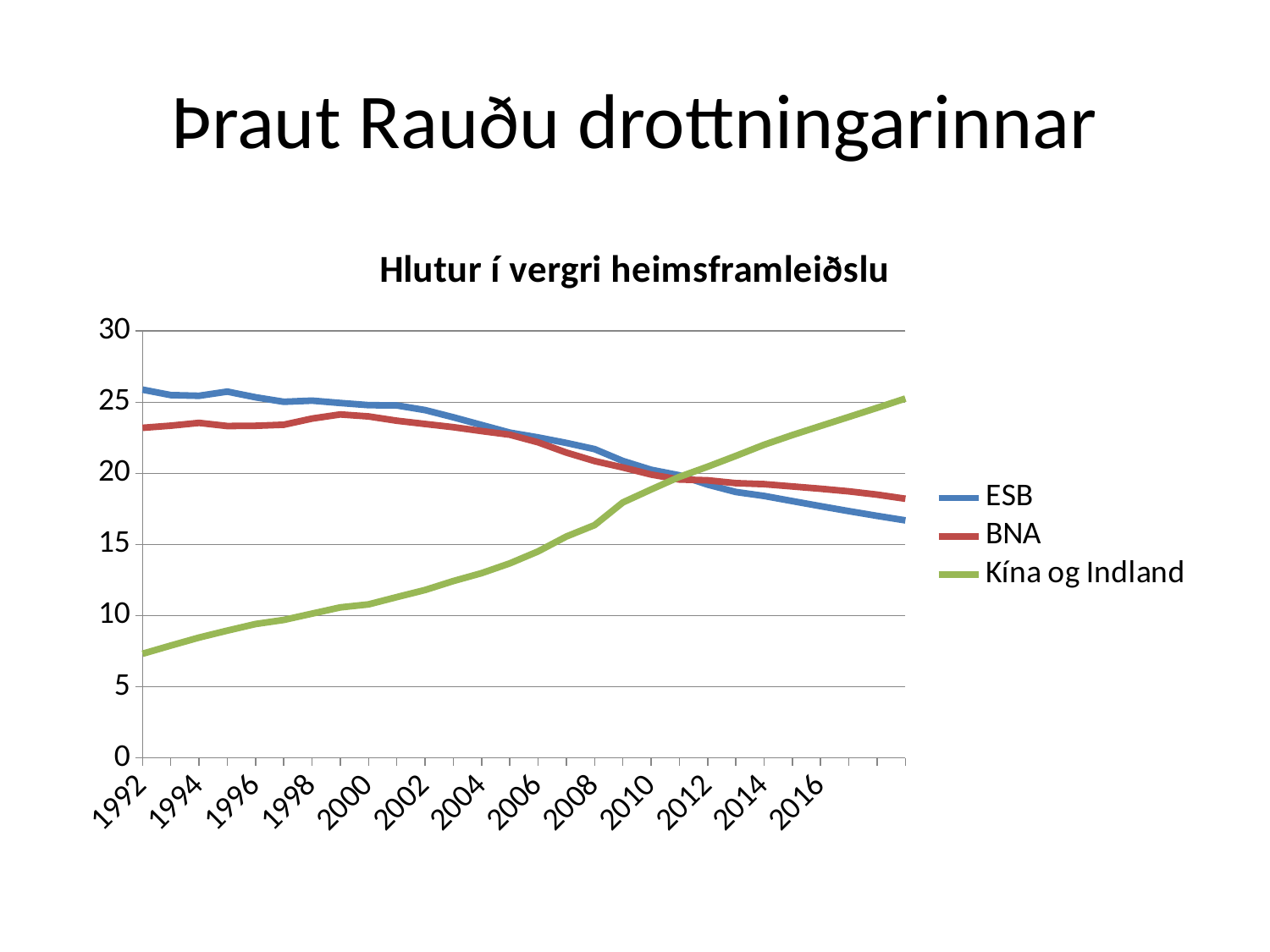
What kind of chart is shown on the slide? line chart What is the title of the chart? Hlutur í vergri heimsframleiðslu Which series has the highest value in 1992? ESB Which series is drawn in green? Kína og Indland Is the value for Kína og Indland in 1992 greater or less than 10? less Is the value for Kína og Indland in 2016 greater or less than 20? greater Which series has the lowest value in 1992? Kína og Indland How many series does the legend list? 3 In 2000, which is larger: the value for ESB or the value for Kína og Indland? ESB Does the ESB line rise or fall from 1992 to the end of the series? fall Which series has the highest value in 2016? Kína og Indland Does the Kína og Indland line rise or fall from 1992 to the end of the series? rise